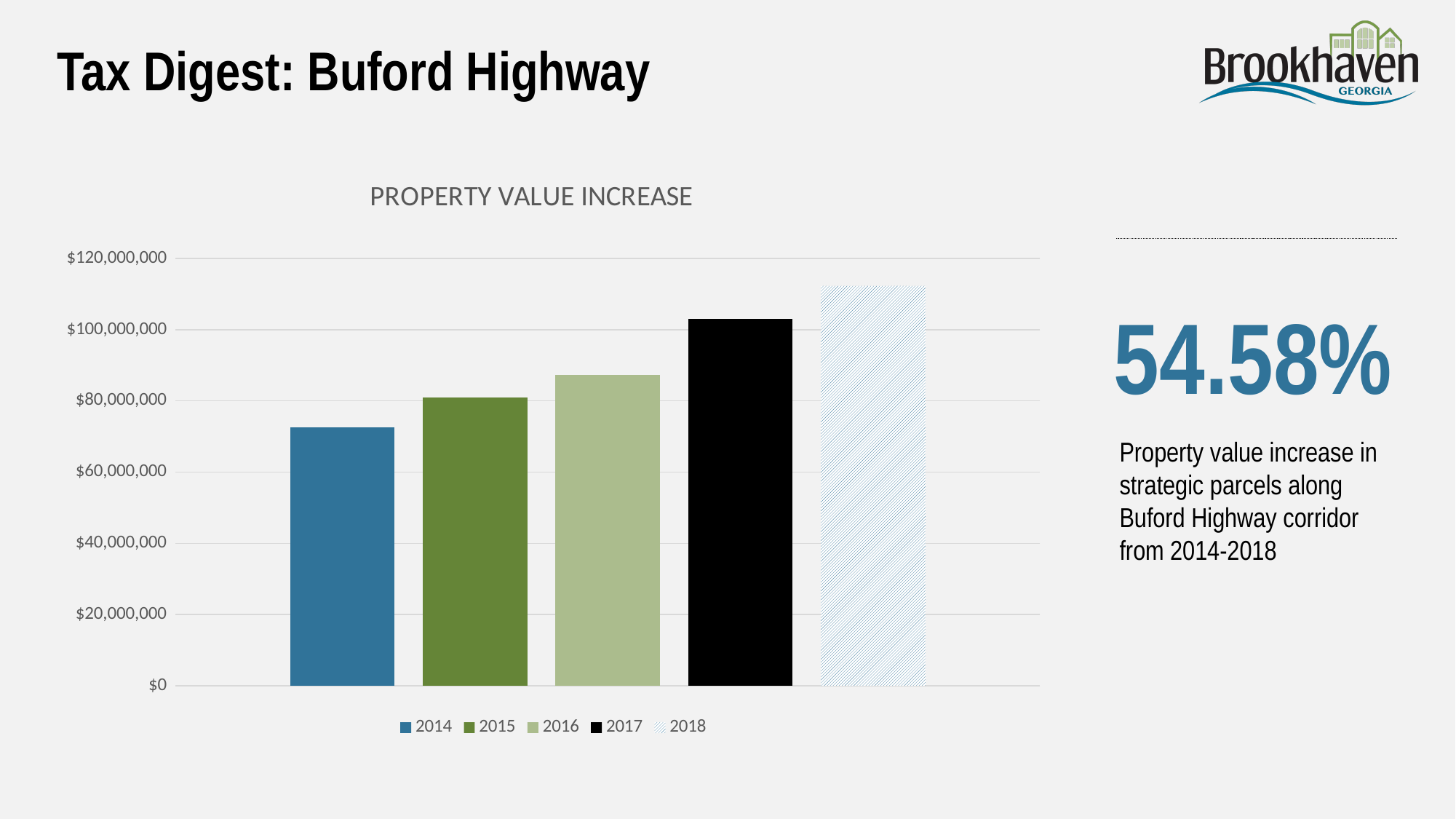
Is the value for 2016 greater or less than $80,000,000? greater How many bars are plotted in the chart? 5 Is the value for 2018 greater or less than $120,000,000? less What is the title of the chart? PROPERTY VALUE INCREASE Which year has the lowest property value in the chart? 2014 Do the property values rise or fall from 2014 to 2018? rise Which is larger, the value for 2017 or the value for 2015? 2017 Is the value for 2014 greater or less than $80,000,000? less What kind of chart is shown on the slide? bar chart Which year has the highest property value in the chart? 2018 How many entries does the chart legend list? 5